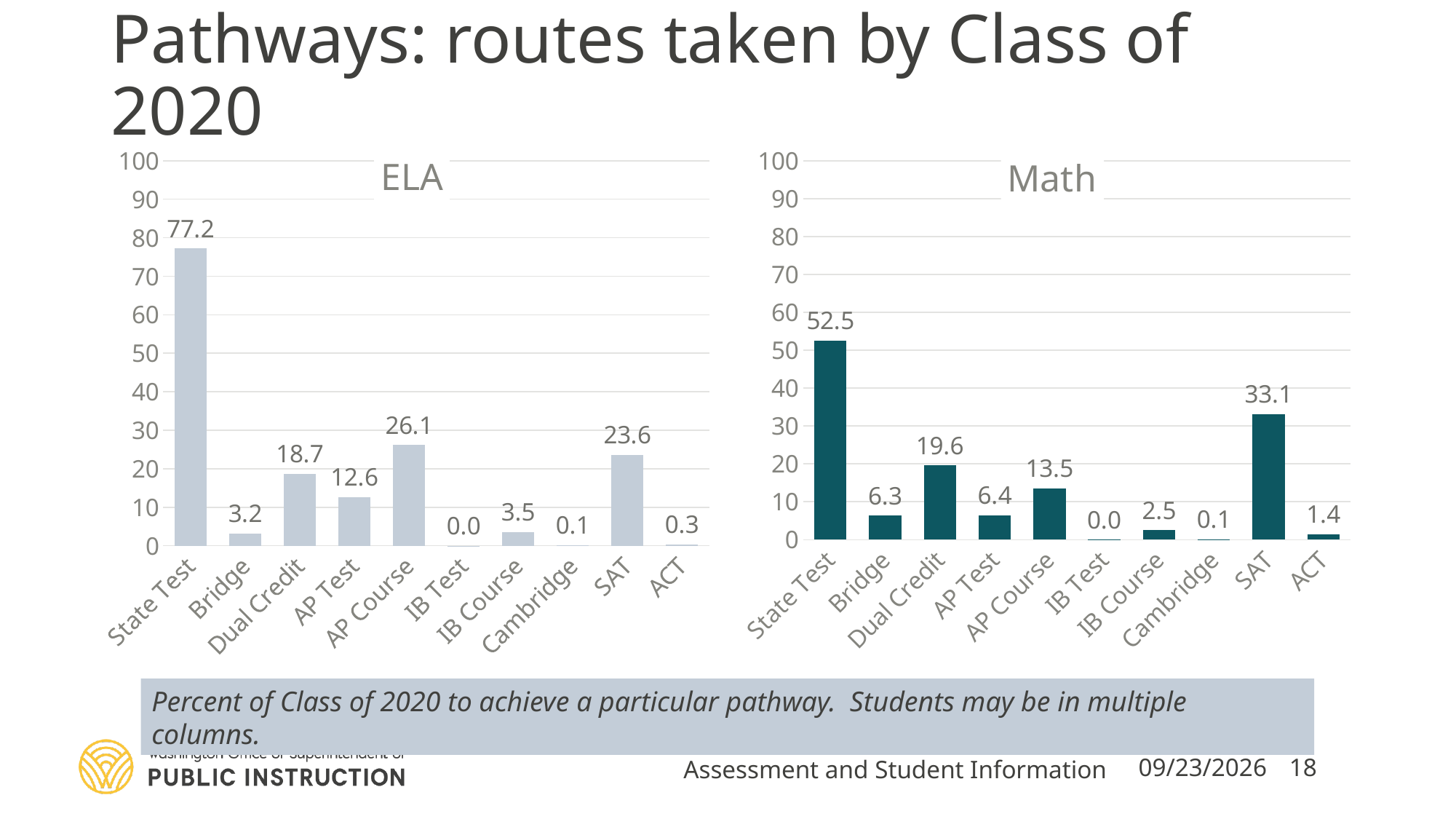
In the Math chart, which category has the highest value? State Test In the ELA chart, what is the value for AP Course? 26.1 In the ELA chart, what is the value for State Test? 77.2 In the ELA chart, what is the difference between Dual Credit and AP Test? 6.1 In the Math chart, which is larger, Dual Credit or AP Course? Dual Credit In the Math chart, what is the difference between State Test and SAT? 19.4 In the Math chart, what is the value for SAT? 33.1 In the ELA chart, which category has the lowest value? IB Test How many categories are shown in the Math chart? 10 What is the title of the chart on the right side of the slide? Math What kind of chart is the ELA chart? bar chart In the ELA chart, is the value for SAT greater or less than 20? greater